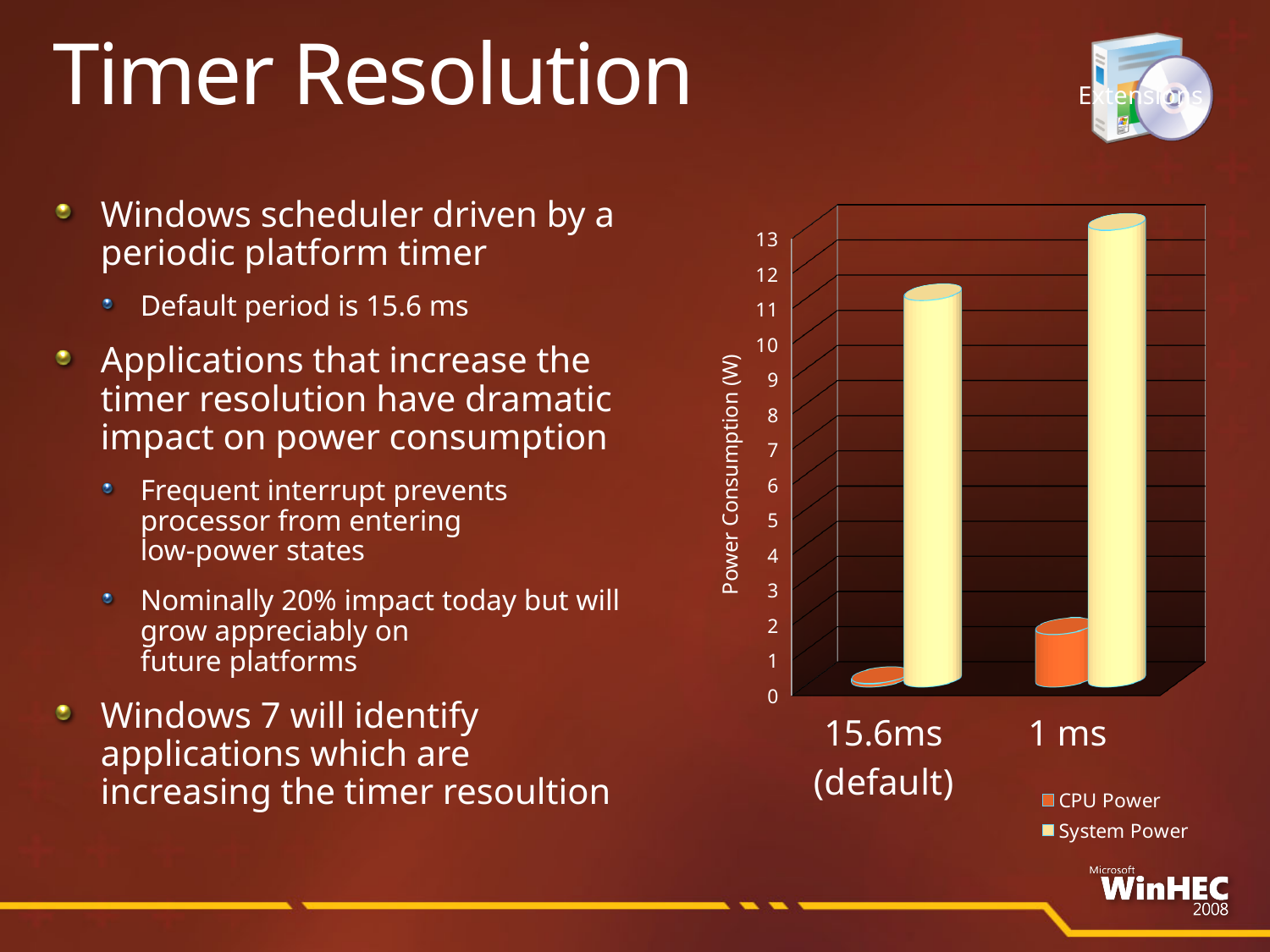
What kind of chart is shown on the slide? bar chart Which timer setting has the higher System Power, 15.6ms (default) or 1 ms? 1 ms Which series has the lowest value for the 15.6ms (default) category? CPU Power Which timer setting has the higher CPU Power, 15.6ms (default) or 1 ms? 1 ms How many categories are shown on the x axis of the chart? 2 What are the two series listed in the chart legend? CPU Power and System Power What is the label on the vertical axis of the chart? Power Consumption (W) Is the CPU Power value for 15.6ms (default) greater or less than 1? less How many series does the chart legend list? 2 Is the CPU Power value for 1 ms greater or less than 3? less Is the System Power value for 1 ms greater or less than 12? greater